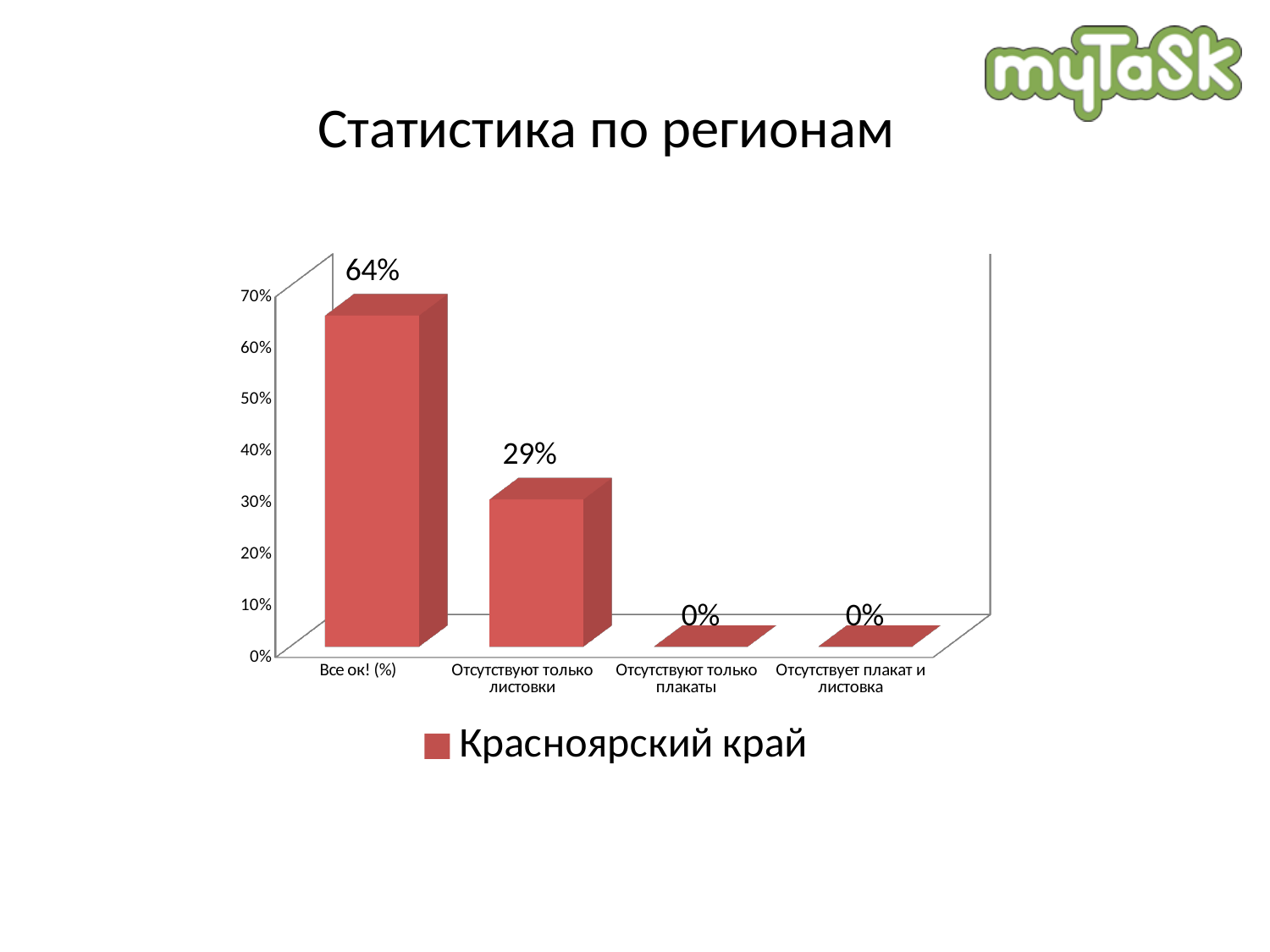
What series name is shown in the legend? Красноярский край How many series does the legend list? 1 What is the difference between the values for "Все ок! (%)" and "Отсутствуют только листовки"? 35% What is the value for "Отсутствуют только плакаты"? 0% What is the value for "Все ок! (%)"? 64% What kind of chart is shown on the slide? bar chart How many categories are shown on the x axis? 4 What is the value for "Отсутствуют только листовки"? 29% Is the value for "Отсутствуют только листовки" greater or less than 40%? less What is the value for "Отсутствует плакат и листовка"? 0% Which category has the highest value? Все ок! (%) Which is larger, the value for "Все ок! (%)" or the value for "Отсутствуют только листовки"? Все ок! (%)